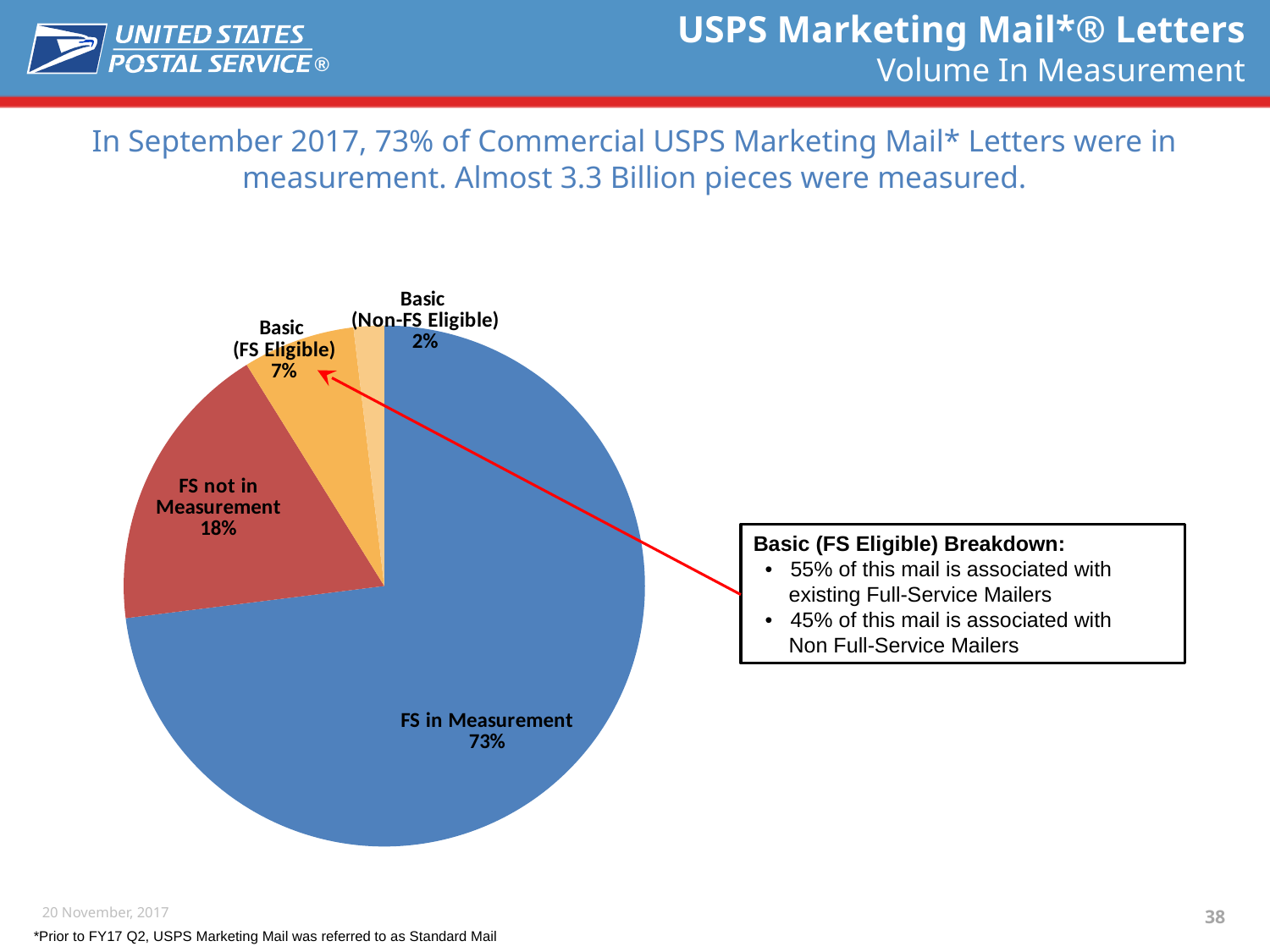
Which slice of the pie is the largest? FS in Measurement What colour is the FS not in Measurement slice? red Which slice of the pie is the smallest? Basic (Non-FS Eligible) What share of the pie is Basic (FS Eligible)? 7% Which is larger, Basic (FS Eligible) or Basic (Non-FS Eligible)? Basic (FS Eligible) What kind of chart is shown on the slide? pie chart How many slices does the pie chart have? 4 What share of the pie is Basic (Non-FS Eligible)? 2% What is the combined share of the two Basic slices? 9% What share of the pie is FS in Measurement? 73% What is the difference in percentage points between FS in Measurement and FS not in Measurement? 55